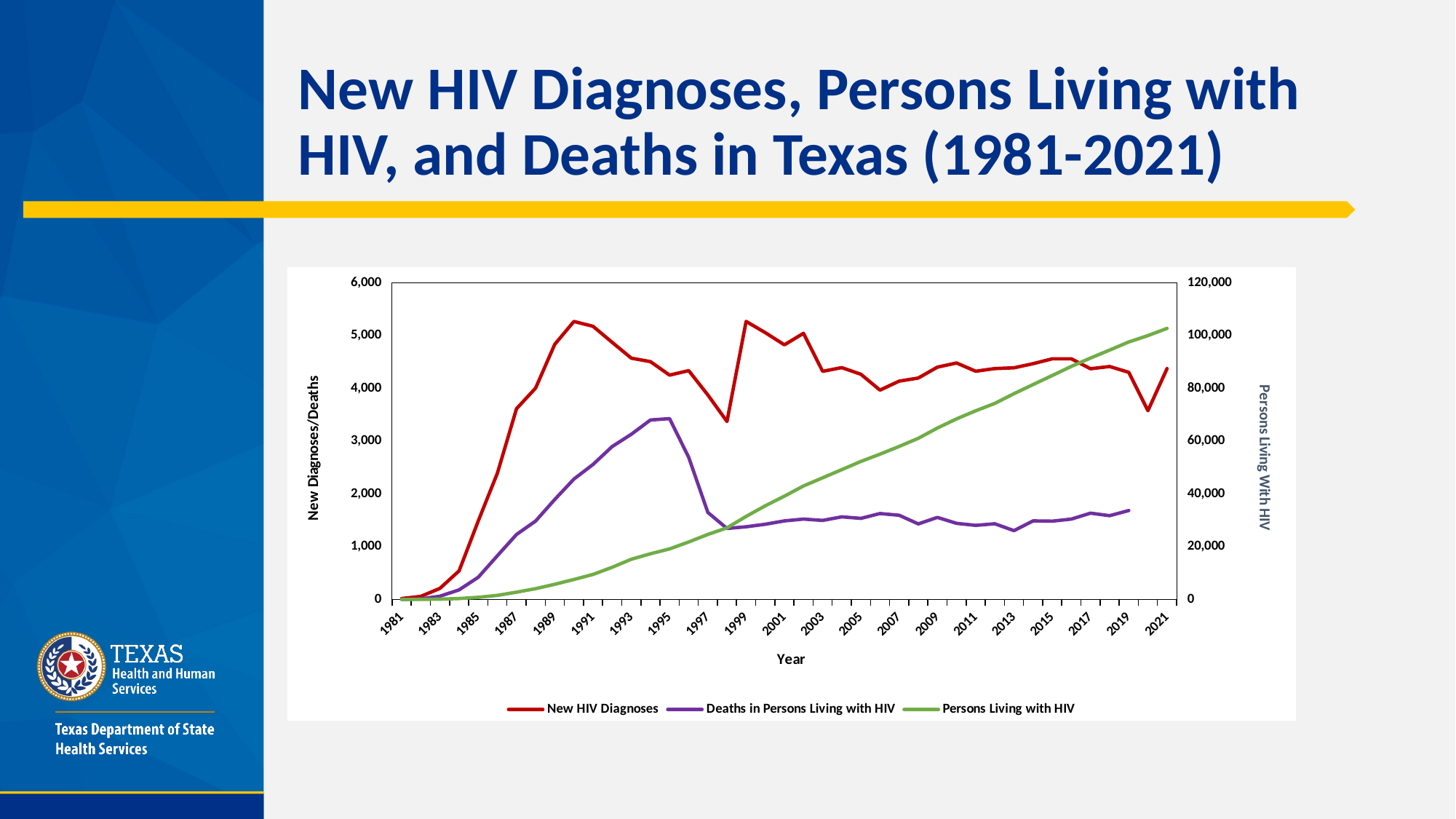
Does the Persons Living with HIV line rise or fall from 1981 to 2021? rise Is the value for Persons Living with HIV in 2021 greater or less than 80,000? greater Does the Deaths in Persons Living with HIV line rise or fall between 1995 and 1998? fall Is the value for Deaths in Persons Living with HIV in 2019 greater or less than 2,000? less What are the three series named in the legend? New HIV Diagnoses, Deaths in Persons Living with HIV, Persons Living with HIV In 1995, which is higher: New HIV Diagnoses or Deaths in Persons Living with HIV? New HIV Diagnoses What kind of chart is shown on the slide? line chart What is the title of the right-hand vertical axis? Persons Living With HIV How many series does the legend list? 3 Is the value for Deaths in Persons Living with HIV in 1995 greater or less than 3,000? greater